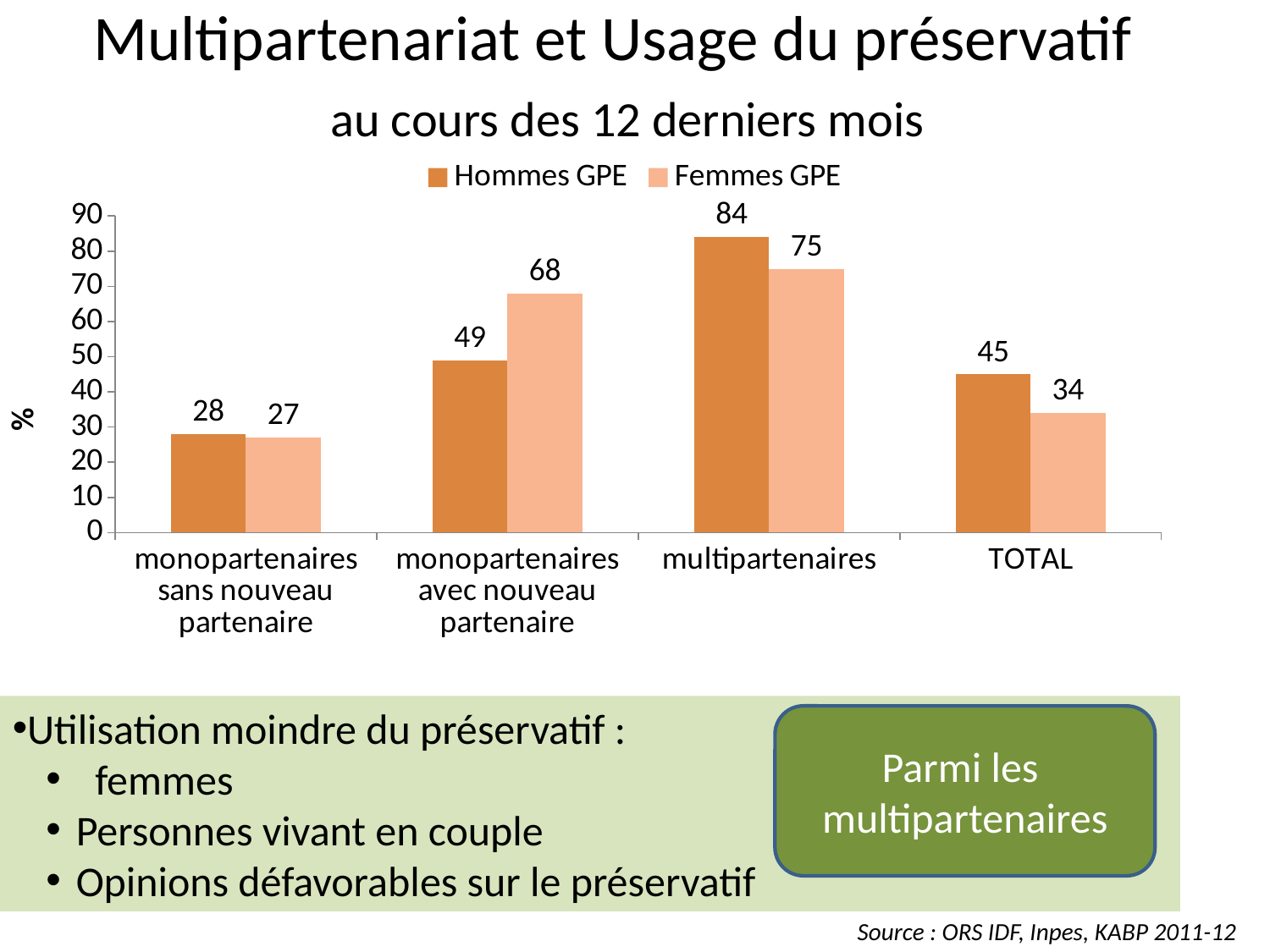
In the monopartenaires avec nouveau partenaire category, which series has the larger value, Hommes GPE or Femmes GPE? Femmes GPE How many series does the legend list? 2 How many categories are shown on the x axis? 4 What is the value for Femmes GPE in the monopartenaires avec nouveau partenaire category? 68 What is the value for Hommes GPE in the multipartenaires category? 84 What is the difference between Hommes GPE and Femmes GPE in the multipartenaires category? 9 Which category has the lowest value for Femmes GPE? monopartenaires sans nouveau partenaire Which category has the highest value for Hommes GPE? multipartenaires What is the value for Femmes GPE in the TOTAL category? 34 What kind of chart is shown on the slide? bar chart What is the difference between Hommes GPE and Femmes GPE in the TOTAL category? 11 What label is shown on the y axis of the chart? %